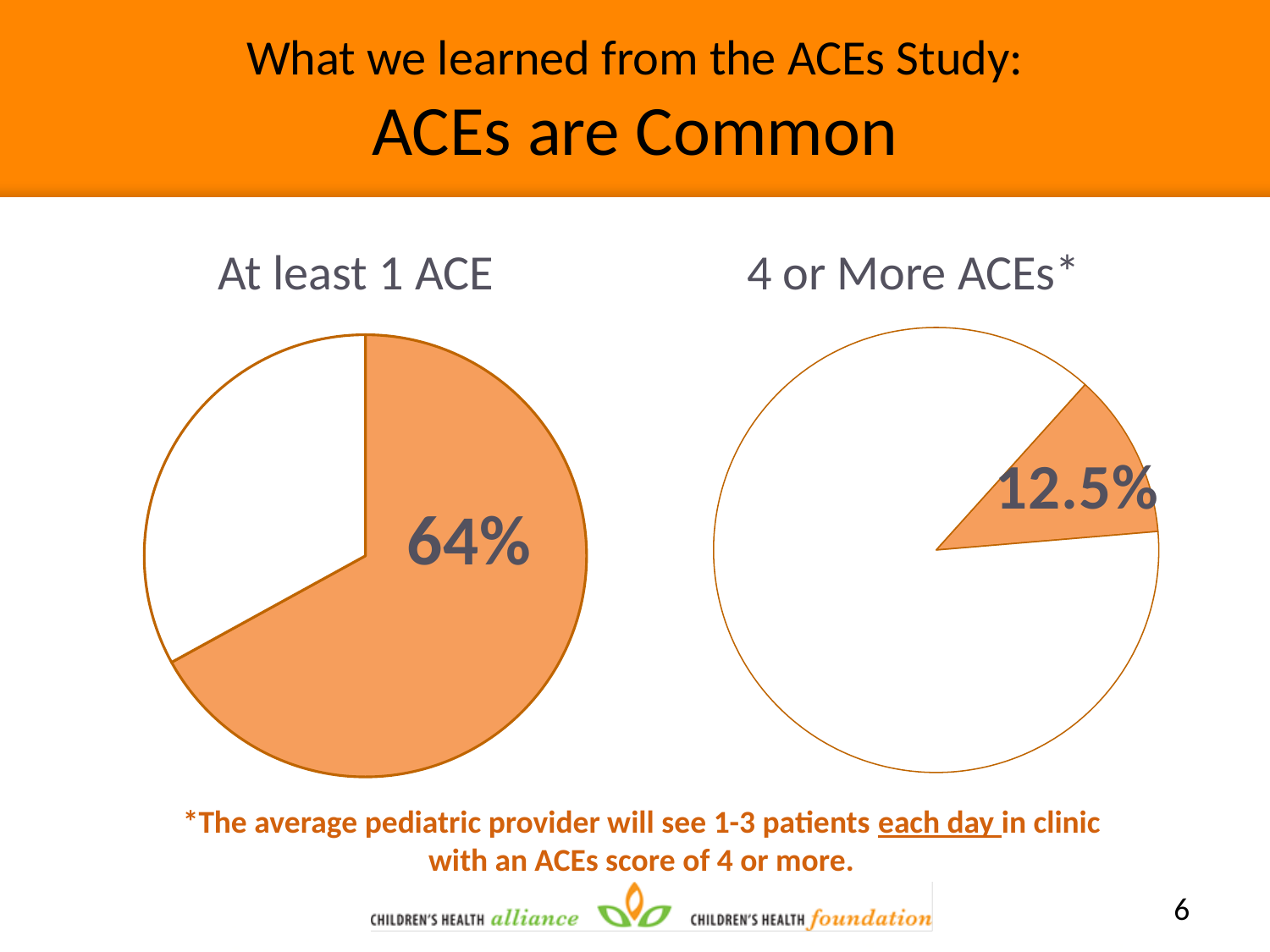
In the 'At least 1 ACE' chart, what percentage does the orange slice represent? 64% How many slices does the 'At least 1 ACE' pie chart have? 2 Which chart has the larger orange slice, 'At least 1 ACE' or '4 or More ACEs*'? At least 1 ACE What kind of chart is the '4 or More ACEs*' chart? Pie chart What is the title of the pie chart on the left? At least 1 ACE What kind of chart is the 'At least 1 ACE' chart? Pie chart In the '4 or More ACEs*' chart, what percentage does the orange slice represent? 12.5% What colour is the labelled slice in the '4 or More ACEs*' chart? Orange How many pie charts are shown on the slide? 2 In the '4 or More ACEs*' chart, what share of the pie is the orange slice? 12.5% What is the difference in percentage points between the labelled slice in the 'At least 1 ACE' chart and the labelled slice in the '4 or More ACEs*' chart? 51.5 In the 'At least 1 ACE' chart, what share of the pie is the orange slice? 64%